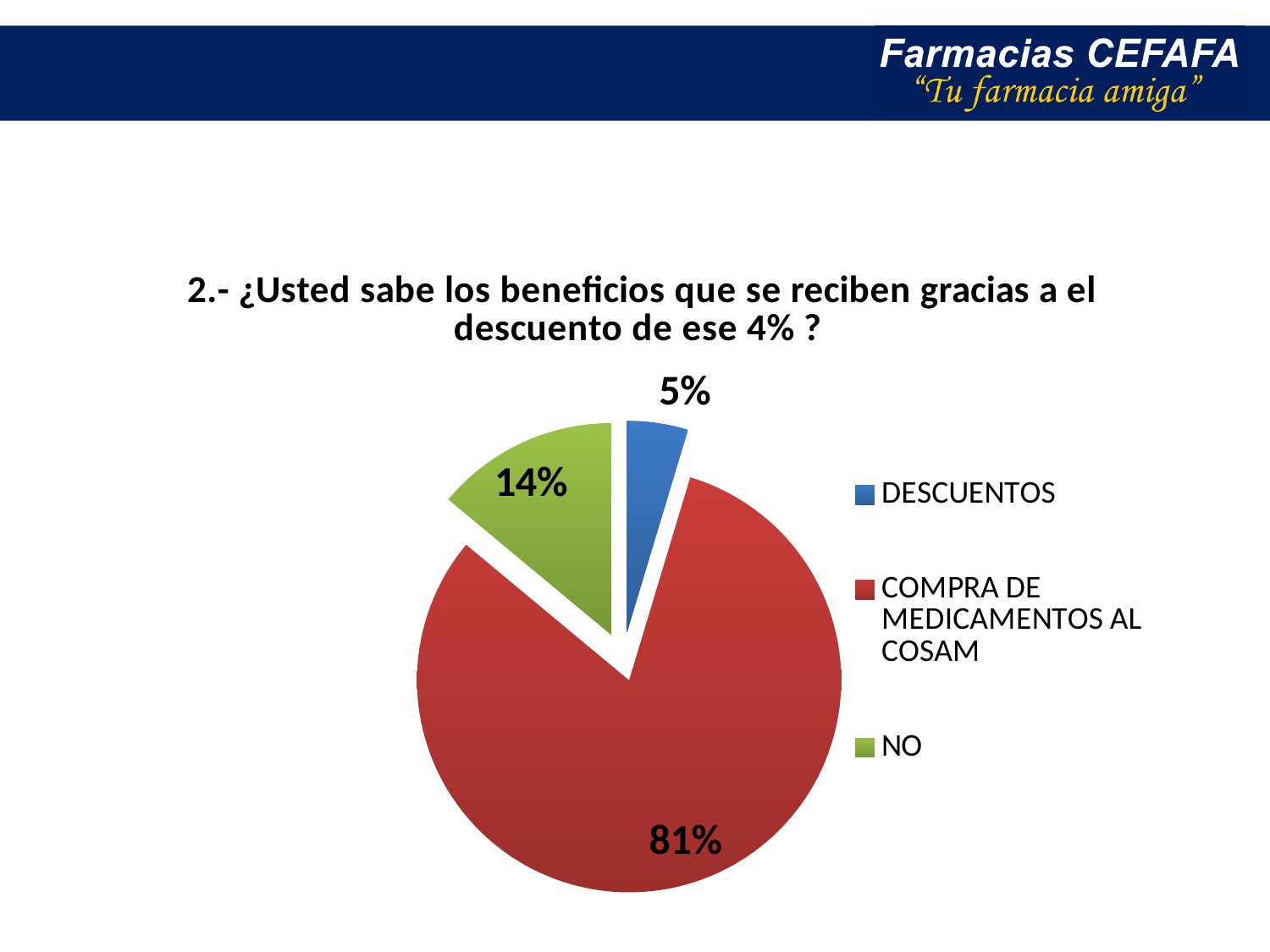
What share of the pie does COMPRA DE MEDICAMENTOS AL COSAM represent? 81% What colour is the slice for NO? green Which is larger, the slice for NO or the slice for DESCUENTOS? NO How many categories are shown in the pie chart? 3 What is the difference in percentage points between NO and DESCUENTOS? 9 Which category has the smallest slice of the pie? DESCUENTOS What is the title of the chart? 2.- ¿Usted sabe los beneficios que se reciben gracias a el descuento de ese 4% ? What is the difference in percentage points between COMPRA DE MEDICAMENTOS AL COSAM and NO? 67 What share of the pie does DESCUENTOS represent? 5% What kind of chart is shown on the slide? pie chart What share of the pie does NO represent? 14% Which category has the largest slice of the pie? COMPRA DE MEDICAMENTOS AL COSAM